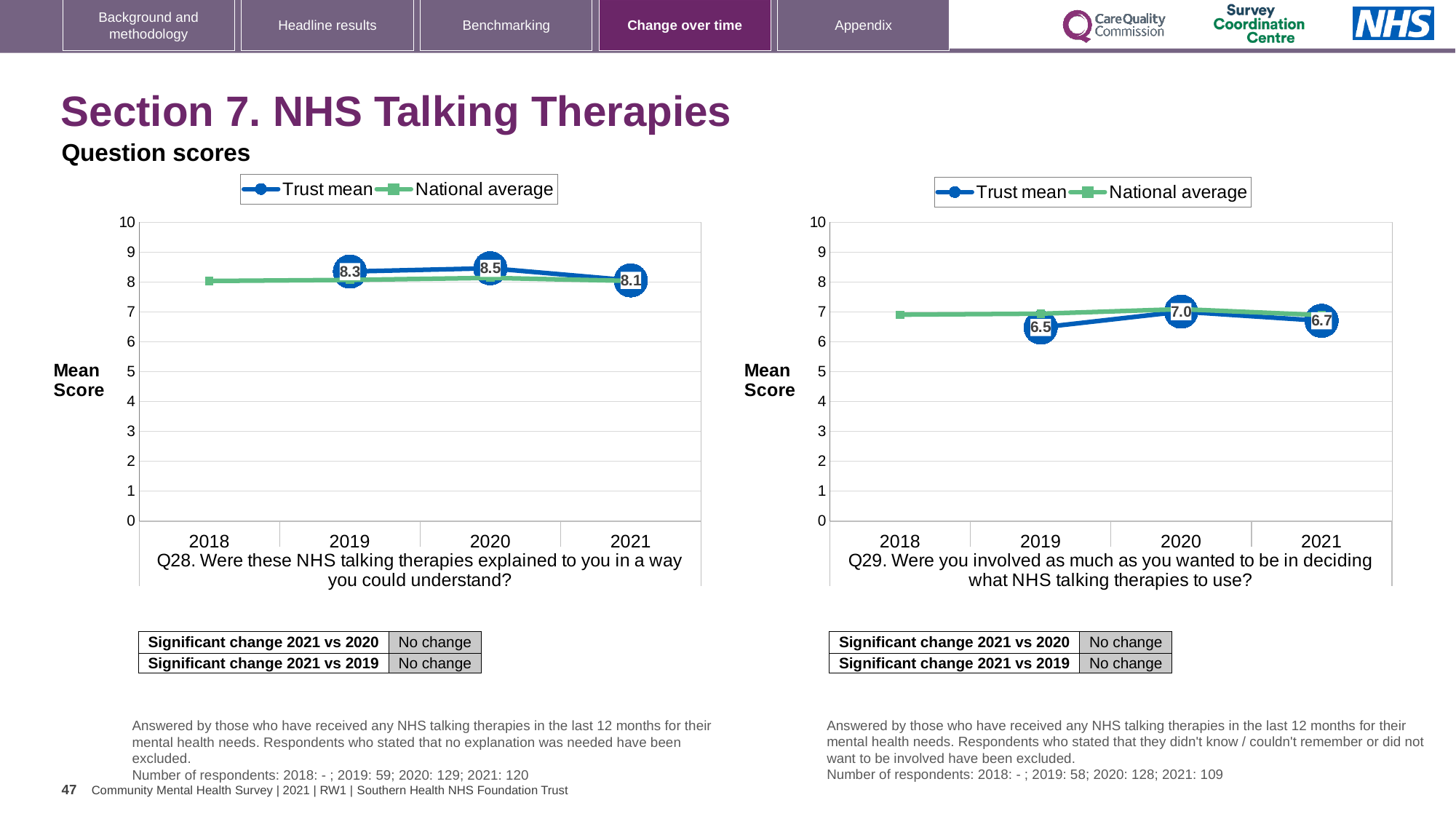
On the right chart (Q29), what is the Trust mean for 2019? 6.5 On the left chart (Q28), what is the difference between the Trust mean in 2020 and in 2021? 0.4 On the right chart (Q29), what is the Trust mean for 2021? 6.7 What kind of chart is the right chart (Q29)? Line chart On the right chart (Q29), what is the difference between the Trust mean in 2020 and in 2019? 0.5 On the left chart (Q28), does the Trust mean rise or fall from 2020 to 2021? Fall On the left chart (Q28), in which year is the Trust mean highest? 2020 On the right chart (Q29), in which year is the Trust mean lowest? 2019 On the left chart (Q28), what is the Trust mean for 2021? 8.1 On the left chart (Q28), what is the Trust mean for 2020? 8.5 On the right chart (Q29), is the Trust mean for 2019 greater or less than 7? less How many series does the legend of the left chart (Q28) list? 2